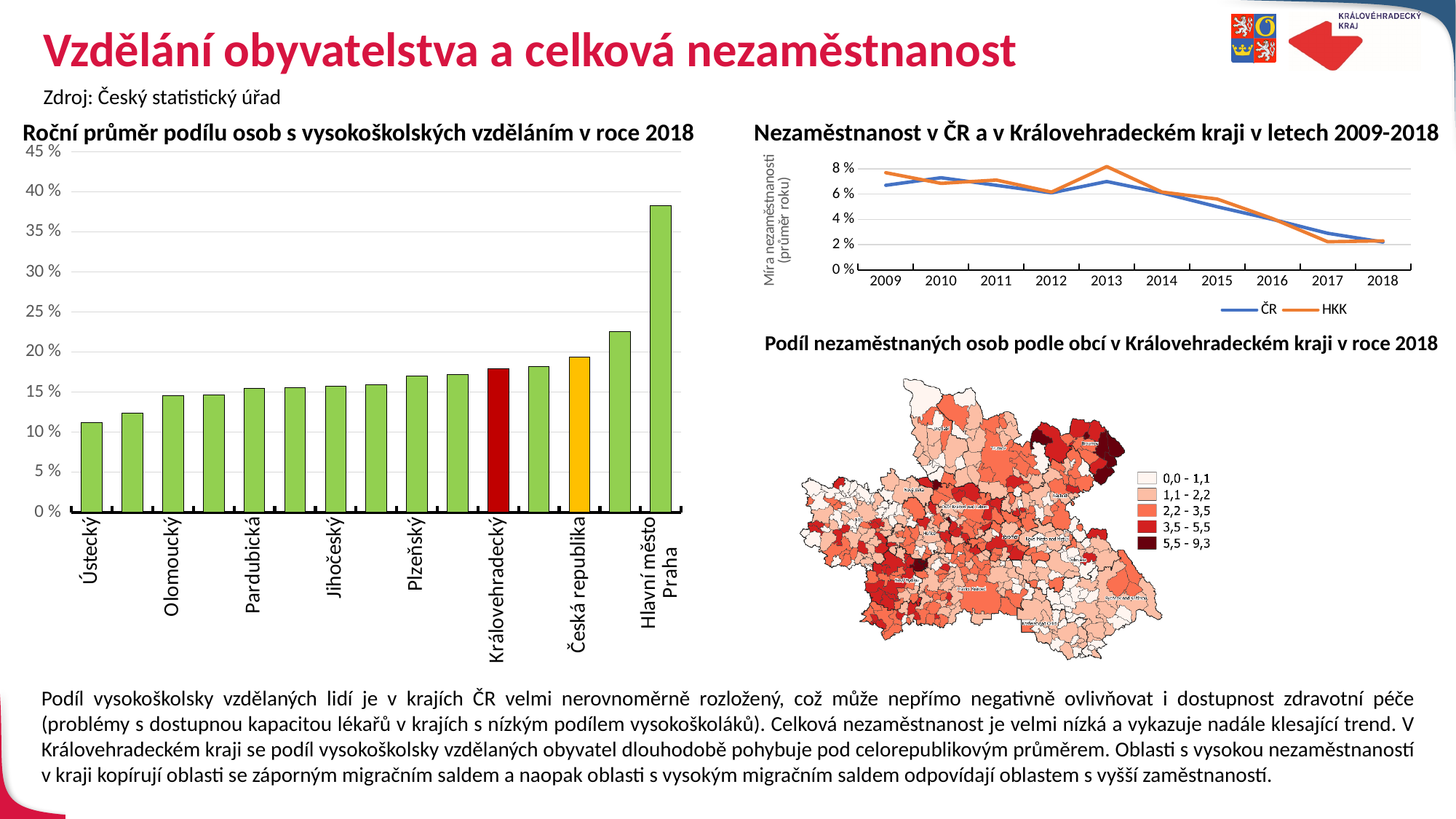
What kind of chart is the top-right chart titled 'Nezaměstnanost v ČR a v Královehradeckém kraji v letech 2009-2018'? line chart How many series does the legend of the top-right line chart list? 2 In the top-right line chart, in which year does the HKK series reach its highest value? 2013 What kind of chart is the left chart titled 'Roční průměr podílu osob s vysokoškolských vzděláním v roce 2018'? bar chart In the left bar chart, what colour is the bar for Královehradecký? red In the top-right line chart, do the values for ČR generally rise or fall from 2013 to 2018? fall How many bars are plotted in the left bar chart? 15 In the left bar chart, is the value for Královehradecký greater or less than 20 %? less In the left bar chart, which category has the lowest value? Ústecký In the left bar chart, which category has the highest value? Hlavní město Praha In the left bar chart, which is larger: the value for Královehradecký or the value for Česká republika? Česká republika In the left bar chart, is the value for Hlavní město Praha greater or less than 35 %? greater